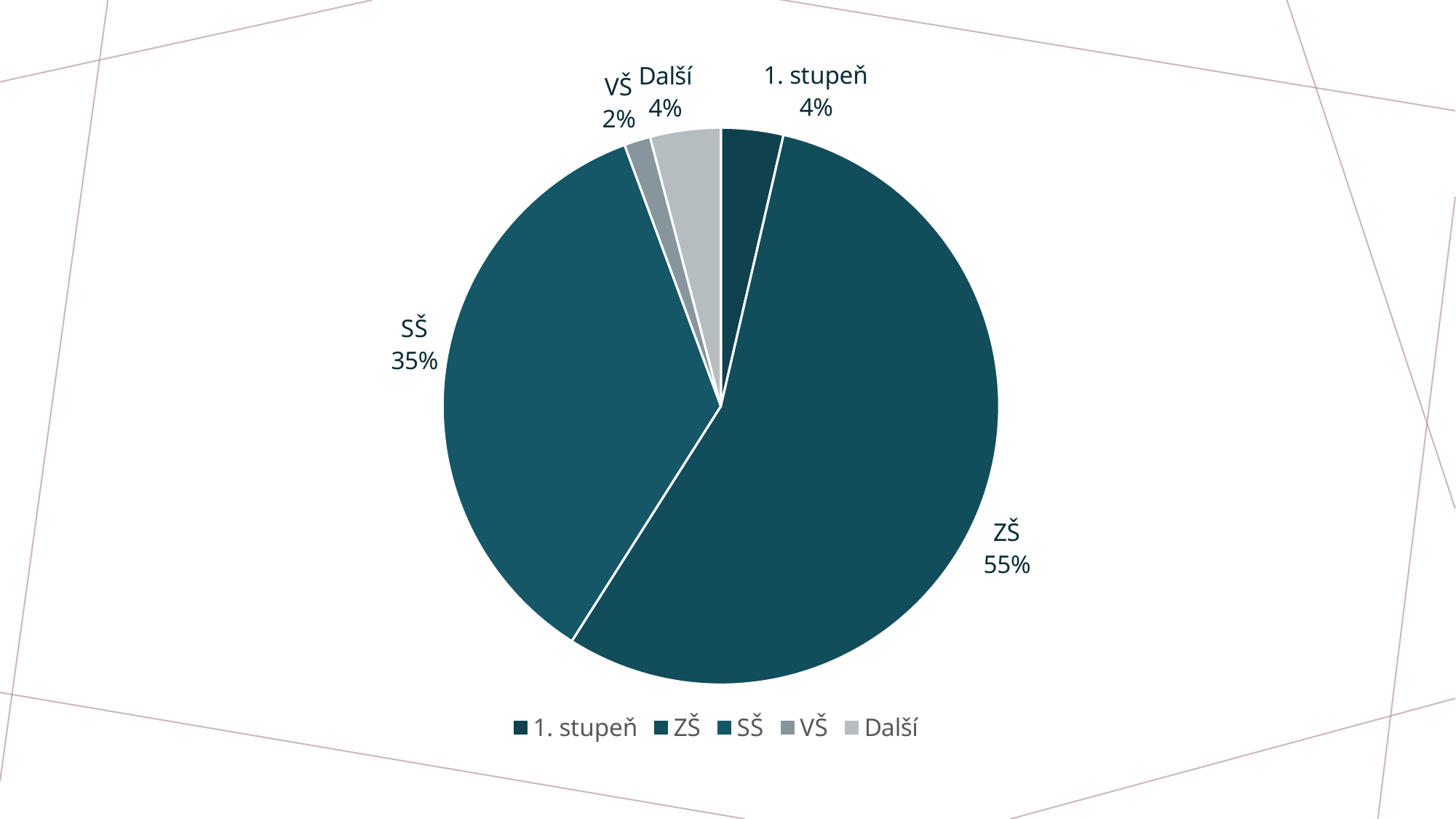
What is the difference between the shares of ZŠ and SŠ? 20% What is the value shown for 1. stupeň? 4% How many slices does the pie chart have? 5 Which is larger, the share for SŠ or the share for Další? SŠ What share of the pie does SŠ have? 35% How many entries does the legend list? 5 Which category has the largest slice of the pie? ZŠ What is the value shown for VŠ? 2% Which category has the smallest slice of the pie? VŠ What share of the pie does ZŠ have? 55% What is the value shown for Další? 4% What kind of chart is shown on the slide? pie chart